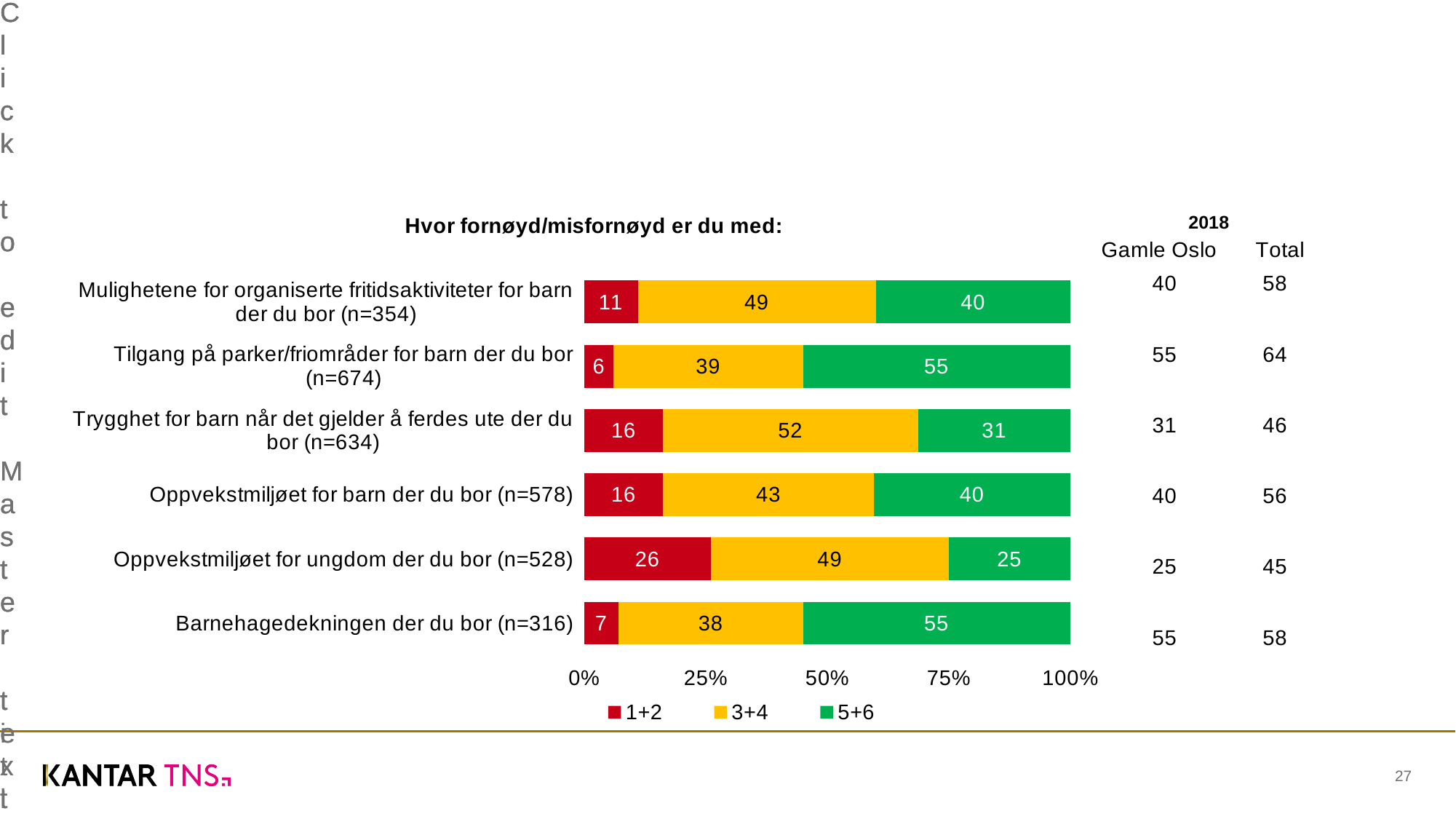
How many categories (questions) are plotted in the chart? 6 Which is larger: the 3+4 value for 'Oppvekstmiljøet for barn der du bor (n=578)' or the 3+4 value for 'Oppvekstmiljøet for ungdom der du bor (n=528)'? Oppvekstmiljøet for ungdom der du bor (n=528) What kind of chart is shown on the slide? Stacked bar chart How many series does the chart legend list? 3 Which category has the lowest 5+6 value? Oppvekstmiljøet for ungdom der du bor (n=528) What is the 5+6 value for 'Tilgang på parker/friområder for barn der du bor (n=674)'? 55 What is the title of the chart? Hvor fornøyd/misfornøyd er du med: What is the difference between the 5+6 value for 'Tilgang på parker/friområder for barn der du bor (n=674)' and the 5+6 value for 'Trygghet for barn når det gjelder å ferdes ute der du bor (n=634)'? 24 What is the 1+2 value for 'Oppvekstmiljøet for ungdom der du bor (n=528)'? 26 What is the 3+4 value for 'Trygghet for barn når det gjelder å ferdes ute der du bor (n=634)'? 52 Which category has the lowest 1+2 value? Tilgang på parker/friområder for barn der du bor (n=674) Which category has the highest 1+2 value? Oppvekstmiljøet for ungdom der du bor (n=528)